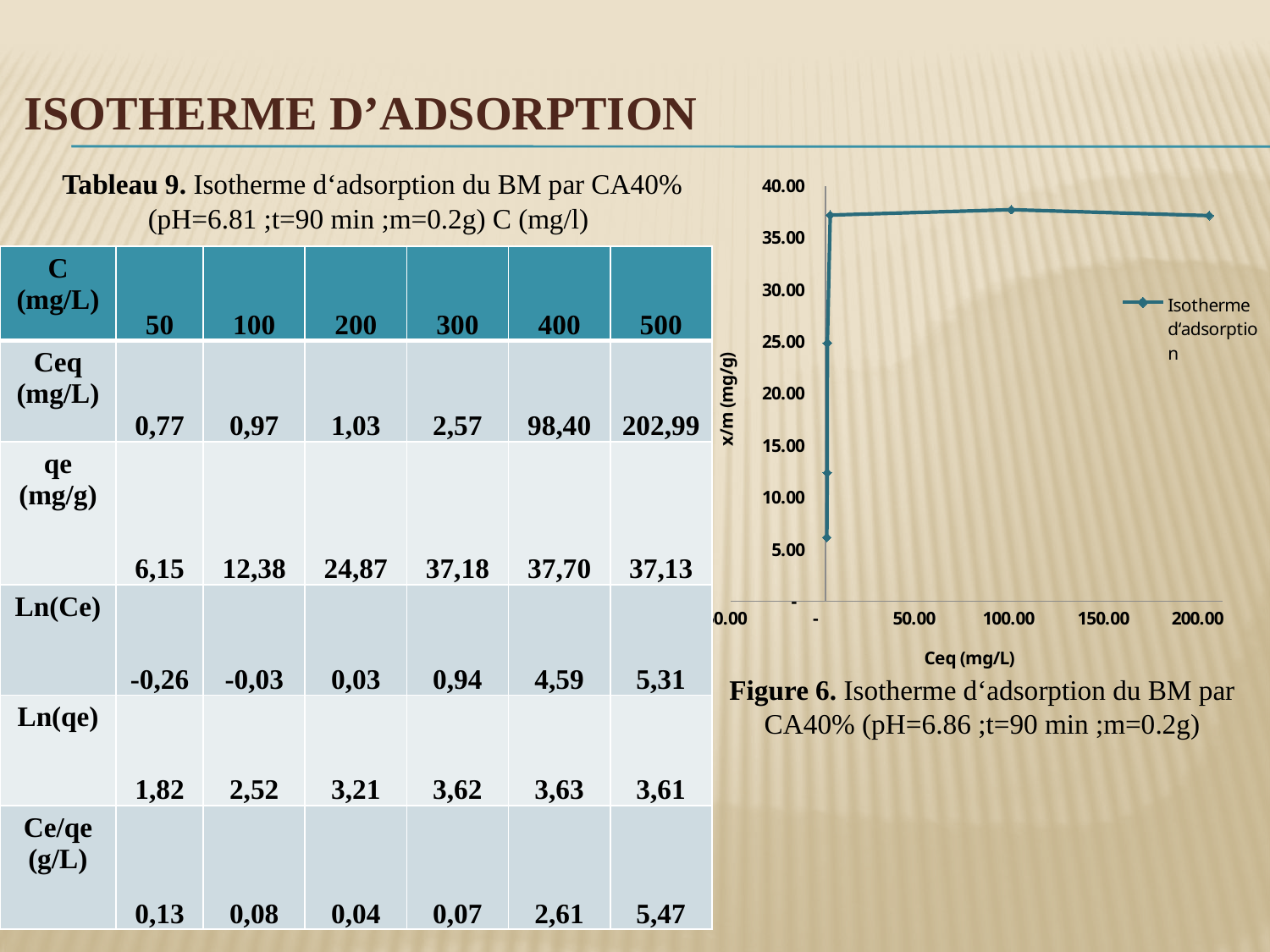
How many series does the legend of the Figure 6 chart list? 1 How many data points are plotted on the Figure 6 chart? 6 What is the highest tick value shown on the y-axis of the Figure 6 chart? 40.00 In the Figure 6 chart, which point has the lowest x/m value? the leftmost point (smallest Ceq) In the Figure 6 chart, which is larger: the x/m value of the lowest point or the x/m value of the rightmost point? the rightmost point In the Figure 6 chart, is the x/m value for the point at Ceq near 100 greater or less than 30.00? greater What kind of chart is shown in Figure 6? line chart What is the y-axis label of the Figure 6 chart? x/m (mg/g) In the Figure 6 chart, is the x/m value for the rightmost point (Ceq near 200) greater or less than 35.00? greater What is the legend entry of the Figure 6 chart? Isotherme d'adsorption In the Figure 6 chart, does x/m rise or fall as Ceq increases from 0 to about 100? rise In the Figure 6 chart, is the x/m value for the lowest point greater or less than 10.00? less